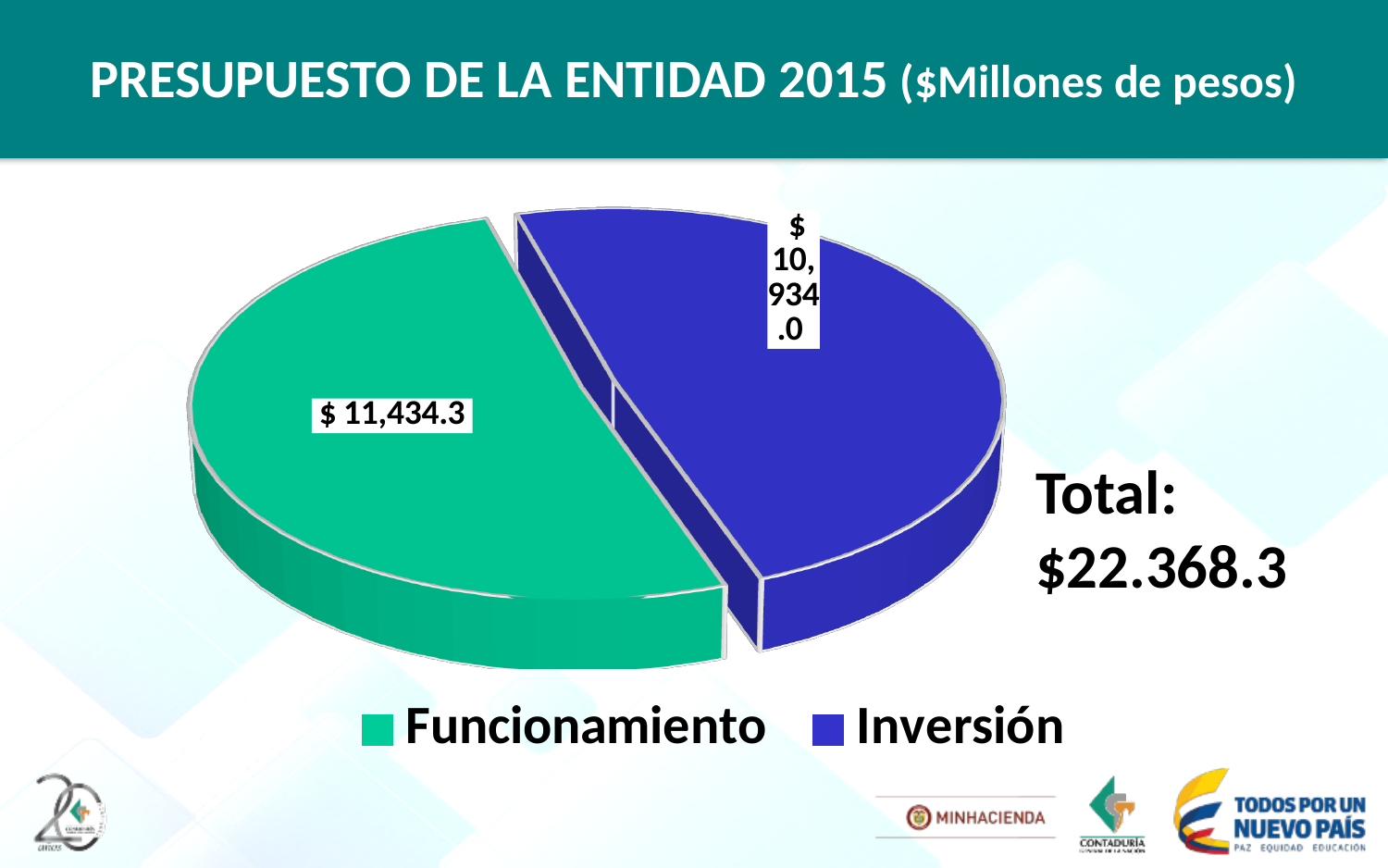
What total is printed next to the pie chart? $22.368.3 What is the difference between the values for Funcionamiento and Inversión? 500.3 What is the value for Funcionamiento? $ 11,434.3 Which category has the largest slice of the pie? Funcionamiento What kind of chart is shown on the slide? Pie chart What is the value for Inversión? $ 10,934.0 How many slices does the pie chart have? 2 How many entries does the legend list? 2 Which category has the smallest slice of the pie? Inversión Which is larger, Funcionamiento or Inversión? Funcionamiento What is the title of the chart? PRESUPUESTO DE LA ENTIDAD 2015 ($Millones de pesos) What colour is the Inversión slice? Blue